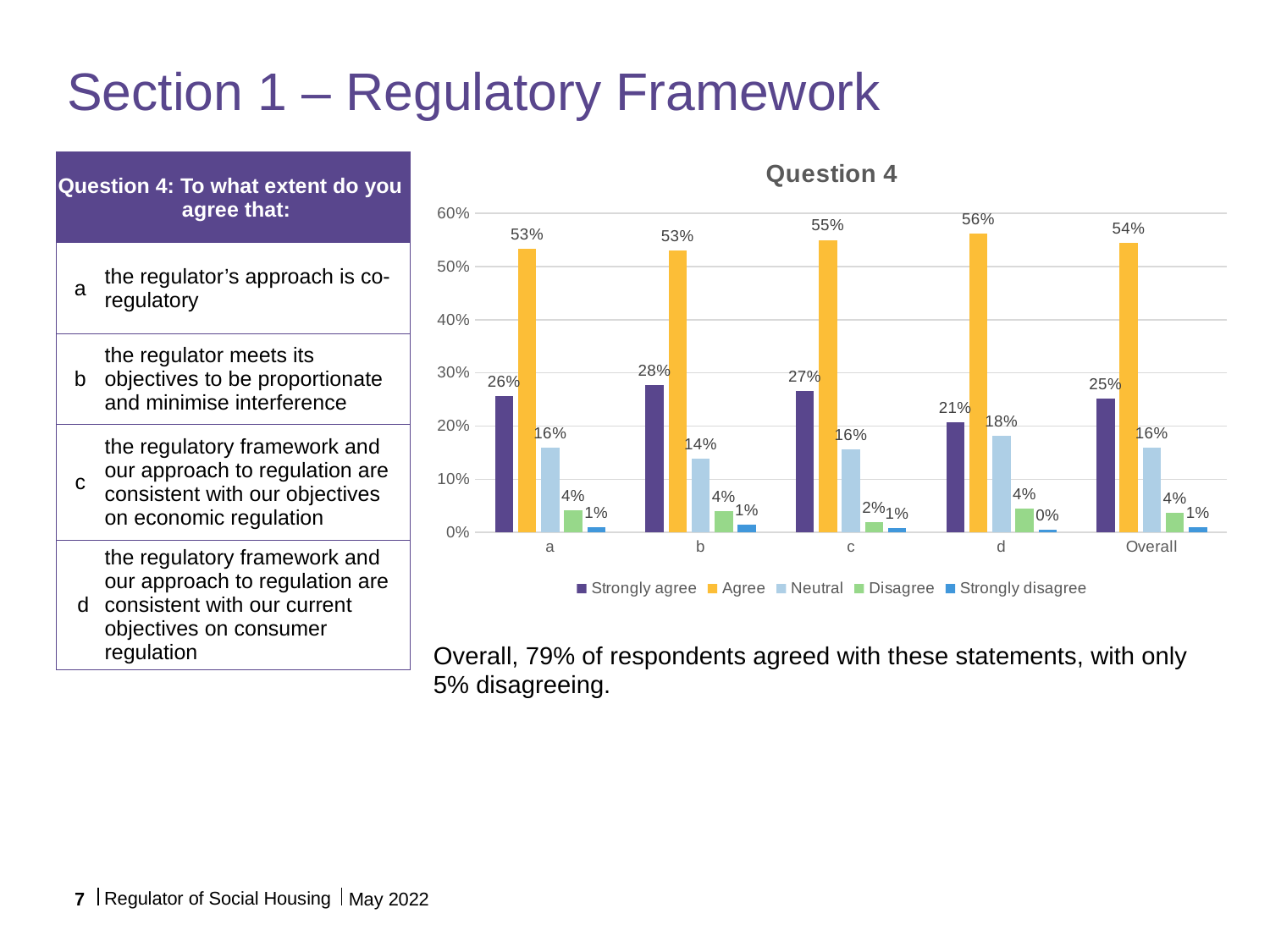
What kind of chart is shown? bar chart What is the value for Agree in category d? 56% What is the value for Strongly agree in category b? 28% What is the difference between the Agree and Strongly agree values in category c? 28% What is the value for Neutral in the Overall category? 16% Which category has the highest Agree value? d What is the title of the chart? Question 4 How many series does the legend list? 5 Is the Neutral value for category d larger or smaller than the Neutral value for category b? larger Which category has the lowest Strongly agree value? d How many categories are shown on the x axis? 5 What is the value for Strongly disagree in category d? 0%